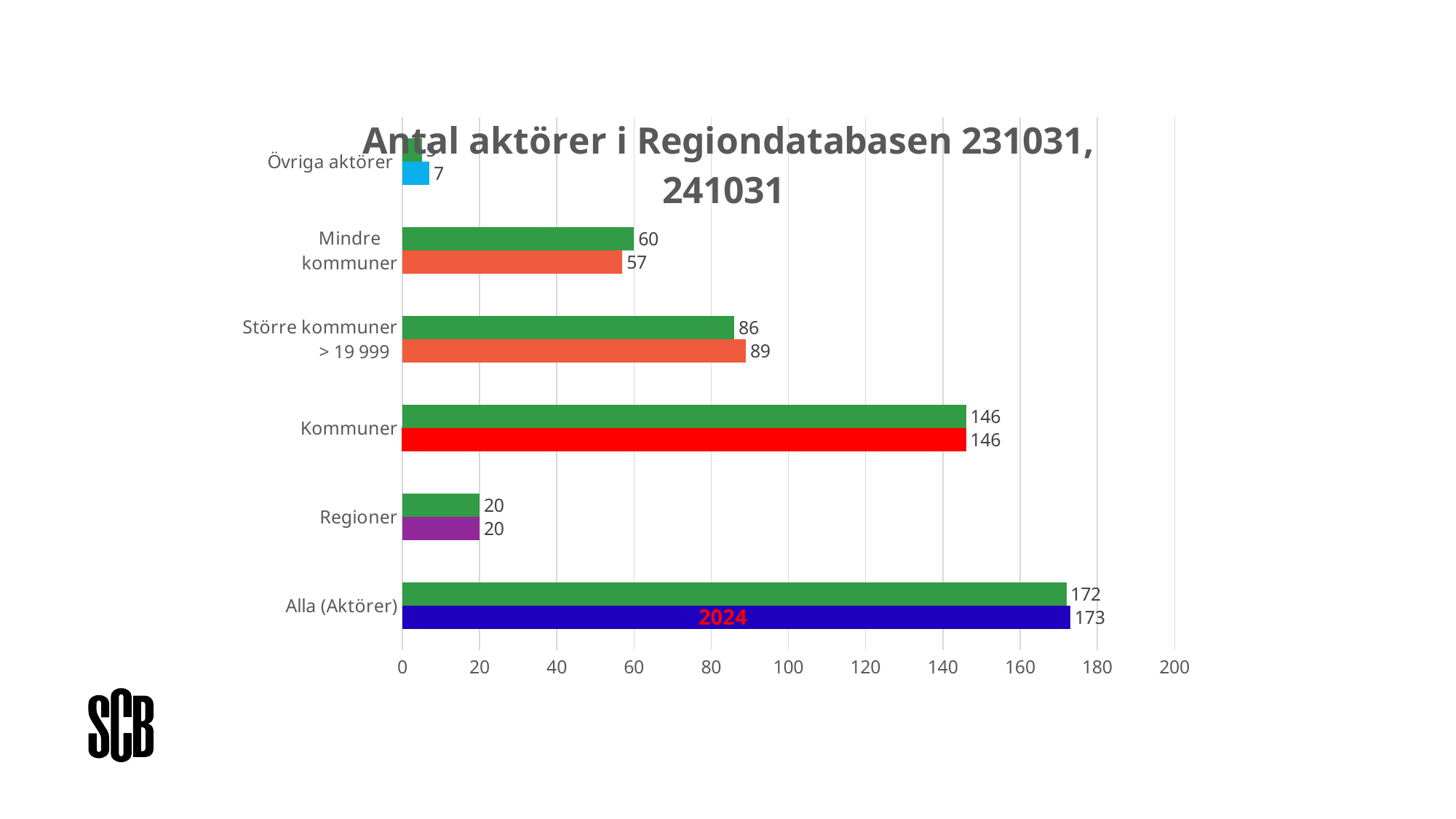
What is the value of the green bar for Alla (Aktörer)? 172 What type of chart is shown on the slide? bar chart What is the value of the green bar for Större kommuner > 19 999? 86 What is the value of the light blue bar for Övriga aktörer? 7 How many categories are shown on the vertical axis of the chart? 6 Which is larger for Mindre kommuner: the green bar or the orange bar? the green bar What is the title of the chart? Antal aktörer i Regiondatabasen 231031, 241031 What is the value of the orange bar for Mindre kommuner? 57 What is the difference between the orange bar (89) and the green bar (86) for Större kommuner > 19 999? 3 Which category has the highest value among the green bars? Alla (Aktörer) Is the value of the red bar for Kommuner greater or less than 140? greater What is the value of the blue bar for Alla (Aktörer)? 173